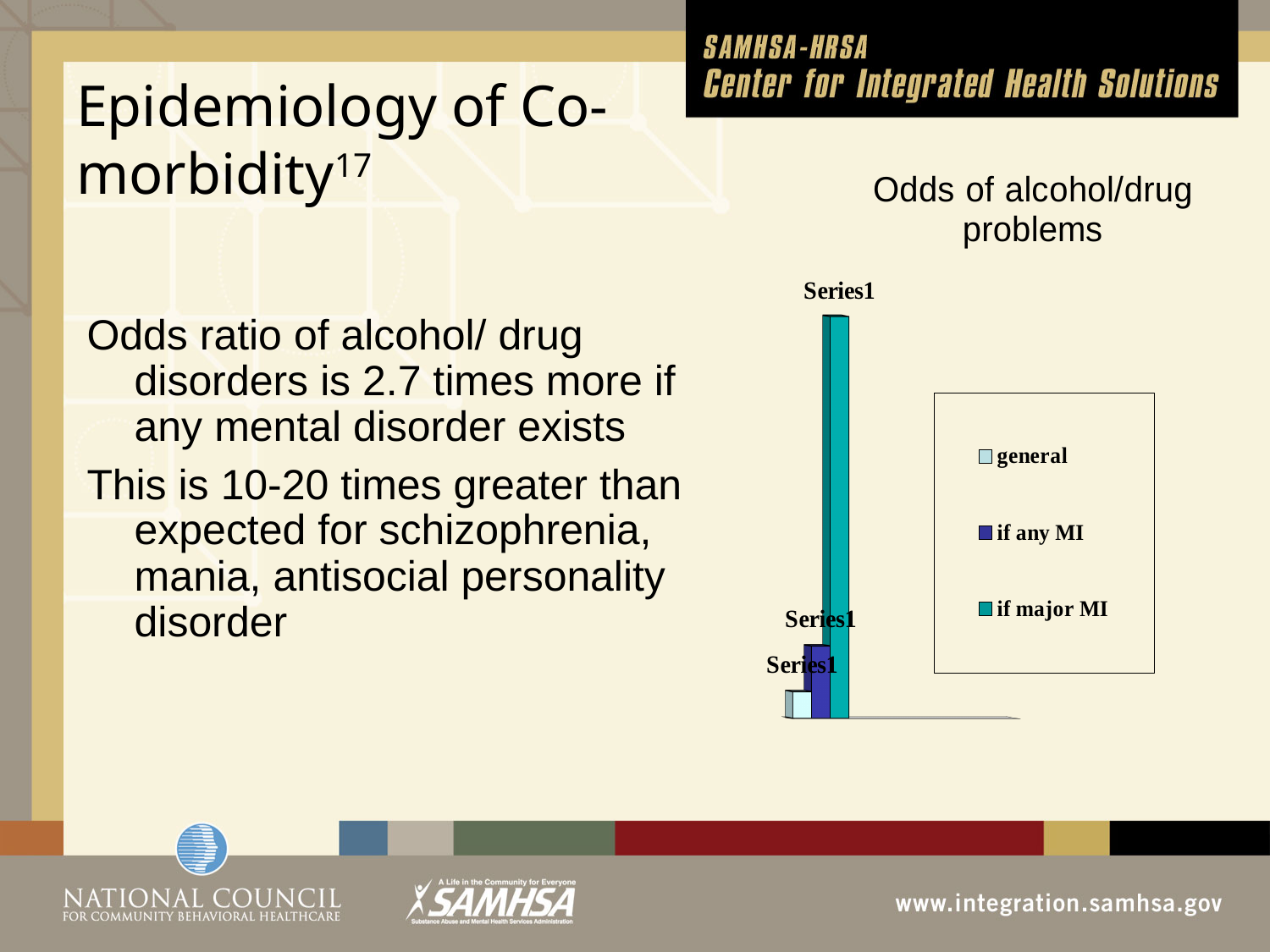
Which legend entry has the shortest bar in the chart? general Which legend entry has the tallest bar in the chart? if major MI How many entries does the chart's legend list? 3 Which bar is taller, 'if any MI' or 'general'? if any MI What text label appears above each bar in the chart? Series1 Which bar is taller, 'if major MI' or 'if any MI'? if major MI What colour is the bar for 'if major MI' in the chart? teal How many bars are plotted in the chart? 3 What is the title of the chart on the slide? Odds of alcohol/drug problems What kind of chart is shown on the slide? bar chart